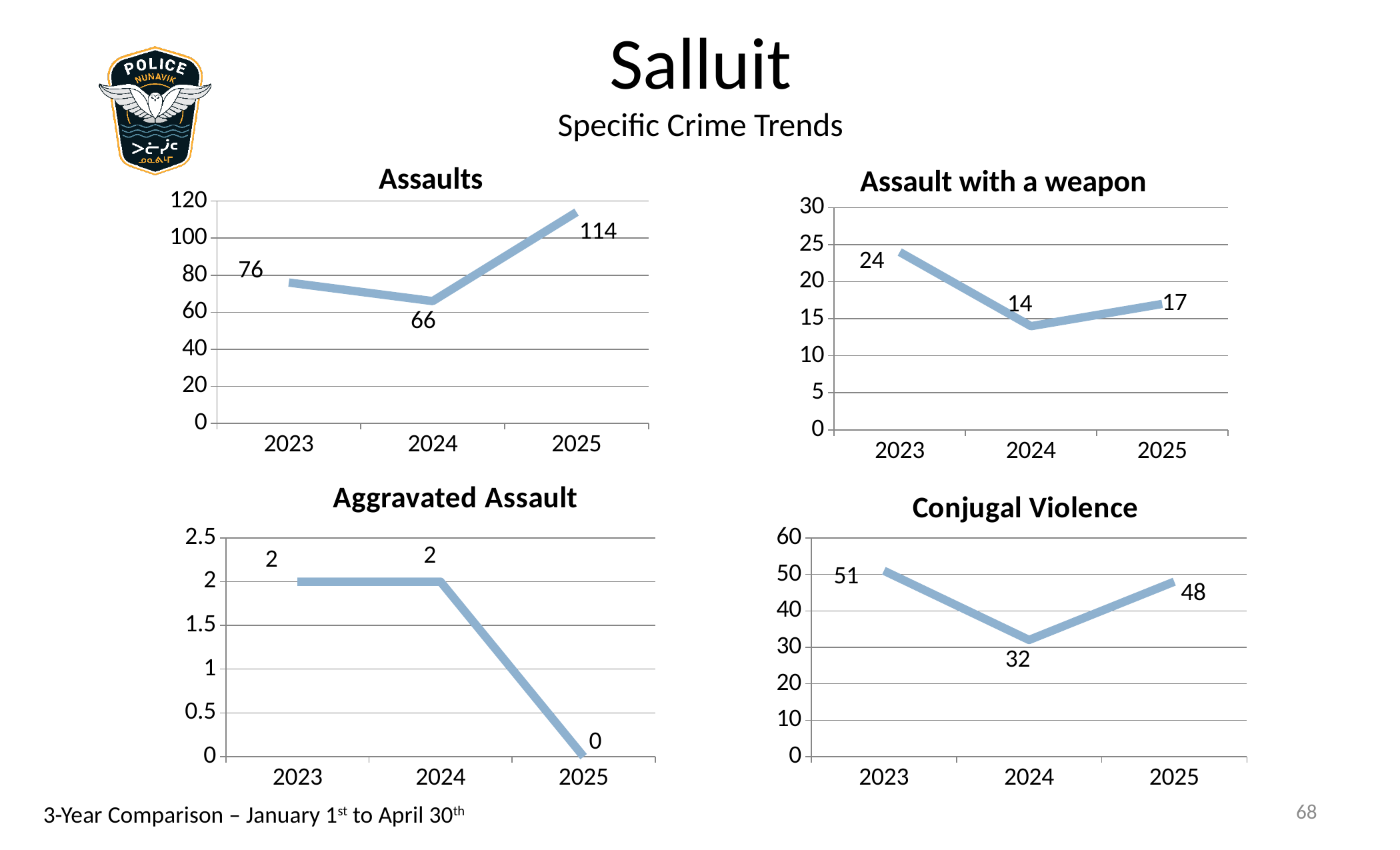
What type of chart is the Conjugal Violence chart? line chart In the Assault with a weapon chart, what is the value for 2023? 24 In the Assaults chart, what is the difference between the 2025 and 2023 values? 38 In the Conjugal Violence chart, what is the value for 2024? 32 In the Assault with a weapon chart, does the value rise or fall from 2023 to 2024? fall In the Aggravated Assault chart, what is the value for 2025? 0 In the Conjugal Violence chart, what is the difference between the 2023 and 2024 values? 19 In the Assault with a weapon chart, is the value for 2024 larger or smaller than the value for 2025? smaller In the Assaults chart, what is the value for 2025? 114 In the Assaults chart, which year has the lowest value? 2024 In the Assault with a weapon chart, which year has the highest value? 2023 In the Aggravated Assault chart, how many years are plotted? 3